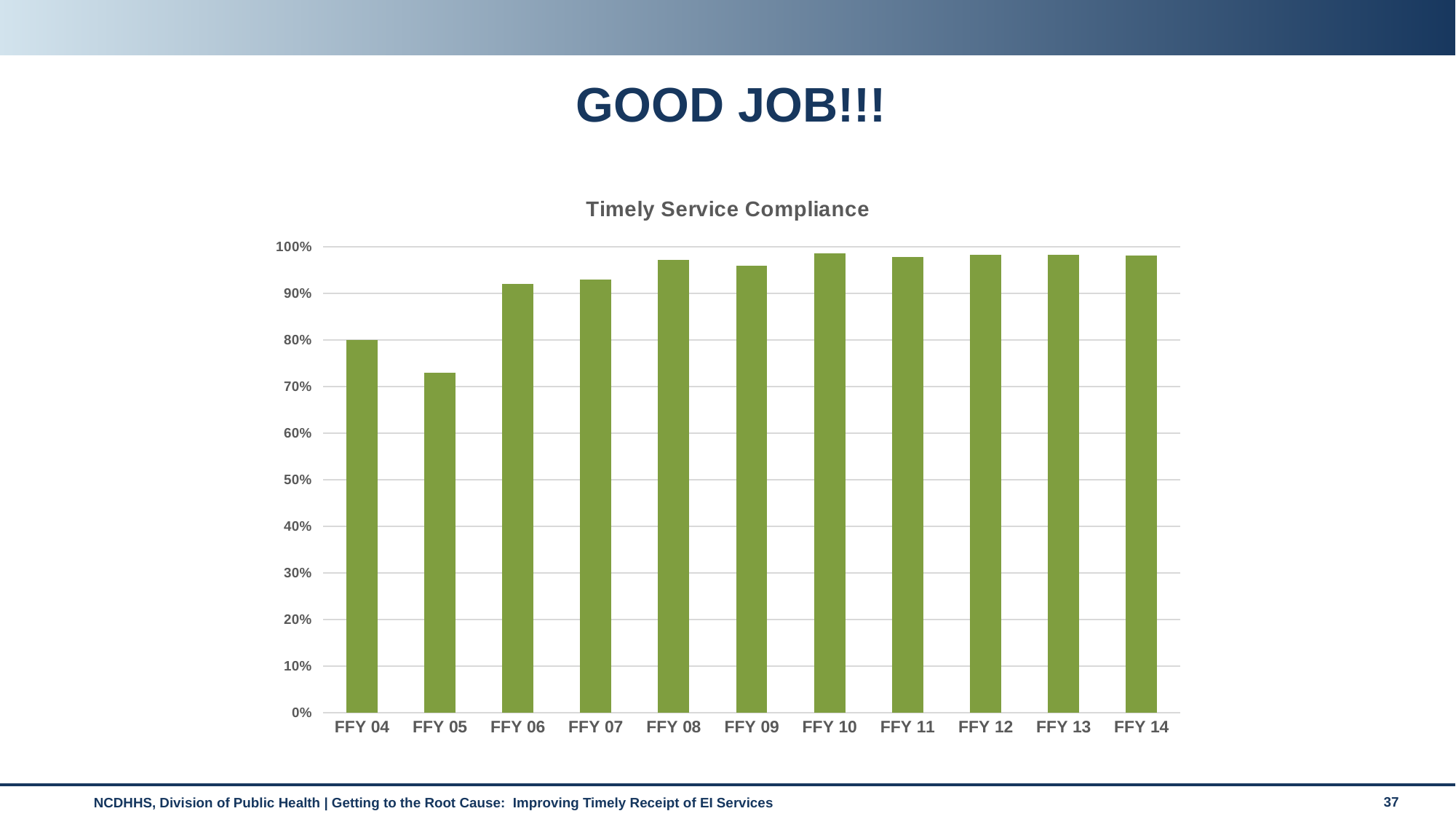
Is the value for FFY 06 greater or less than 90%? greater Which fiscal year has the lowest Timely Service Compliance? FFY 05 What is the title of the chart? Timely Service Compliance Which is larger, the value for FFY 06 or the value for FFY 08? FFY 08 Overall, do the values rise or fall from FFY 04 to FFY 14? Rise Which is larger, the value for FFY 04 or the value for FFY 05? FFY 04 What colour are the bars in the chart? Green What is the Timely Service Compliance value for FFY 04? 80% How many fiscal years (bars) are shown in the chart? 11 Is the value for FFY 05 greater or less than 80%? less What type of chart is shown on the slide? Bar chart Is the value for FFY 08 greater or less than 90%? greater